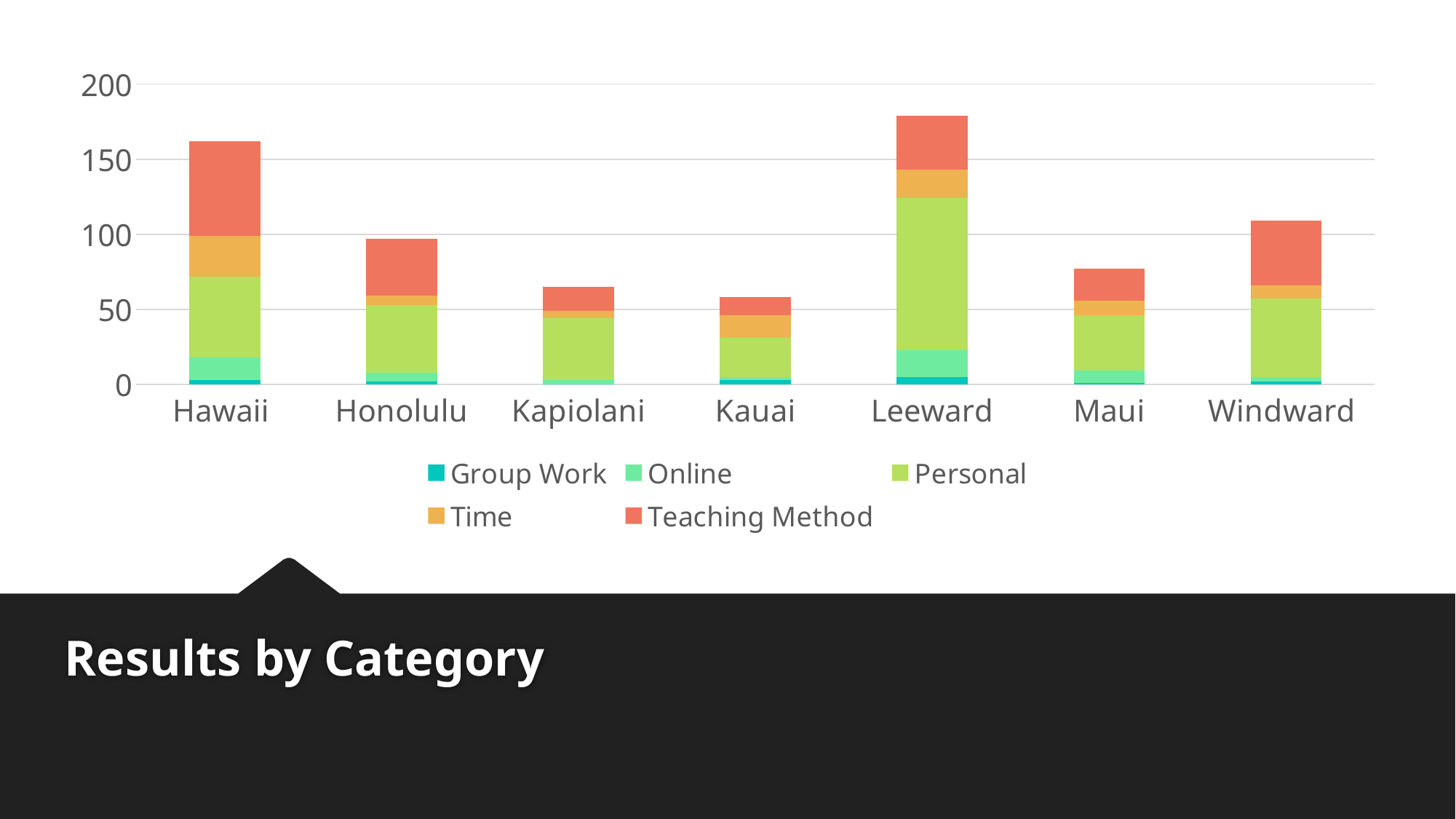
How many series does the legend list? 5 Is the total stacked value for Maui greater or less than 100? less Which series is shown in red/salmon in the legend? Teaching Method What kind of chart is shown on the slide? Stacked bar chart Is the total stacked value for Hawaii greater or less than 150? greater Is the total stacked value for Leeward greater or less than 150? greater Which campus has the largest Personal segment? Leeward Which has the larger total stacked bar, Hawaii or Honolulu? Hawaii What is the title of the slide containing the chart? Results by Category Which campus has the tallest stacked bar overall? Leeward How many campuses (categories) are shown on the x axis? 7